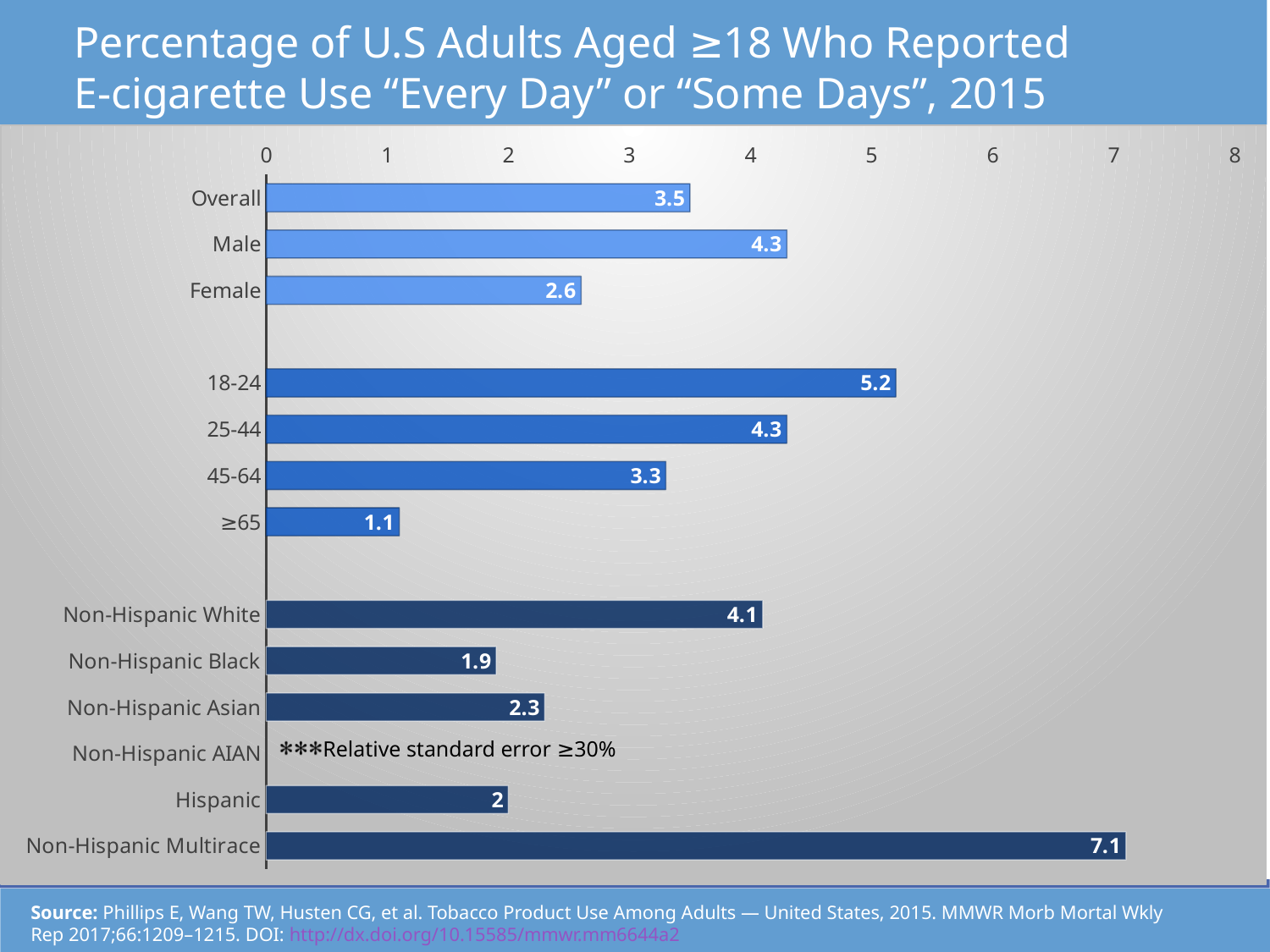
What kind of chart is shown? Bar chart What is the value for Non-Hispanic Multirace? 7.1 Which category has no bar plotted, with a note about relative standard error ≥30%? Non-Hispanic AIAN Which age group has the lowest value? ≥65 What is the difference between the values for 18-24 and ≥65? 4.1 What is the difference between the values for Male and Female? 1.7 Which is larger, the value for Non-Hispanic White or Non-Hispanic Asian? Non-Hispanic White What is the value for Overall? 3.5 Do the values fall as the age groups get older, from 18-24 to ≥65? Yes, they fall Which category has the highest value? Non-Hispanic Multirace What is the value for the 18-24 age group? 5.2 What is the value for Hispanic? 2